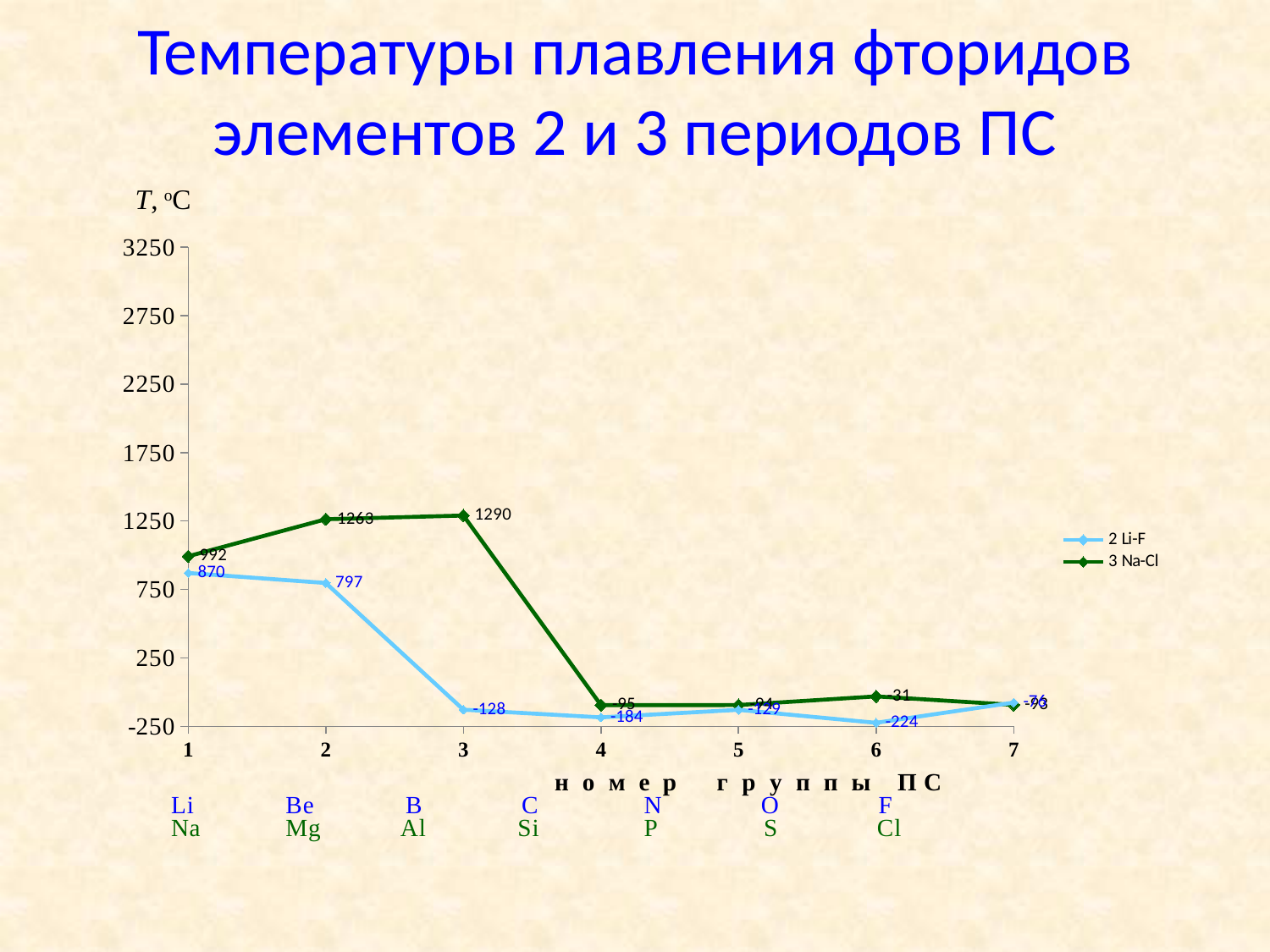
What is the difference between the 2 Li-F values at group 1 and group 2? 73 How many series does the legend list? 2 What is the value of the 3 Na-Cl series at group number 3? 1290 What is the value of the 2 Li-F series at group number 6? -224 At which group number does the 3 Na-Cl series reach its highest value? 3 What kind of chart is shown on the slide? line chart At which group number does the 2 Li-F series have its lowest value? 6 What is the difference between the 3 Na-Cl values at group 3 and group 2? 27 Is the value of the 3 Na-Cl series at group 1 greater or less than 750? greater What is the value of the 3 Na-Cl series at group number 2? 1263 What is the value of the 2 Li-F series at group number 1? 870 At group number 2, which series has the larger value, 2 Li-F or 3 Na-Cl? 3 Na-Cl